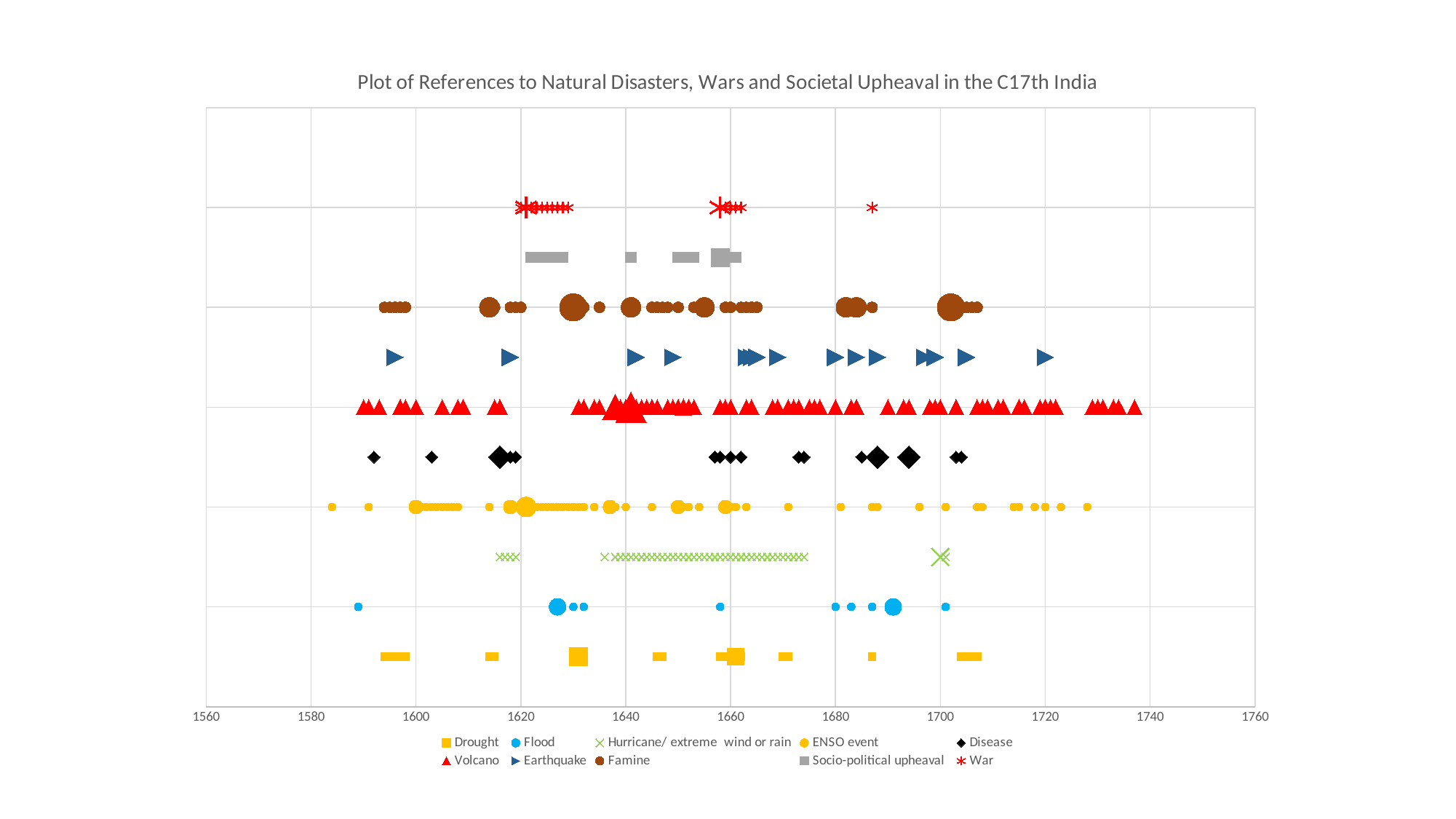
Is the latest Socio-political upheaval marker at a year greater or less than 1680? less How many series does the legend list? 10 What is the title of the chart? Plot of References to Natural Disasters, Wars and Societal Upheaval in the C17th India Is the earliest Drought marker at a year greater or less than 1600? less What is the lowest value shown on the x axis? 1560 Is the latest War marker at a year greater or less than 1700? less What kind of chart is shown on the slide? Scatter chart What is the highest value shown on the x axis? 1760